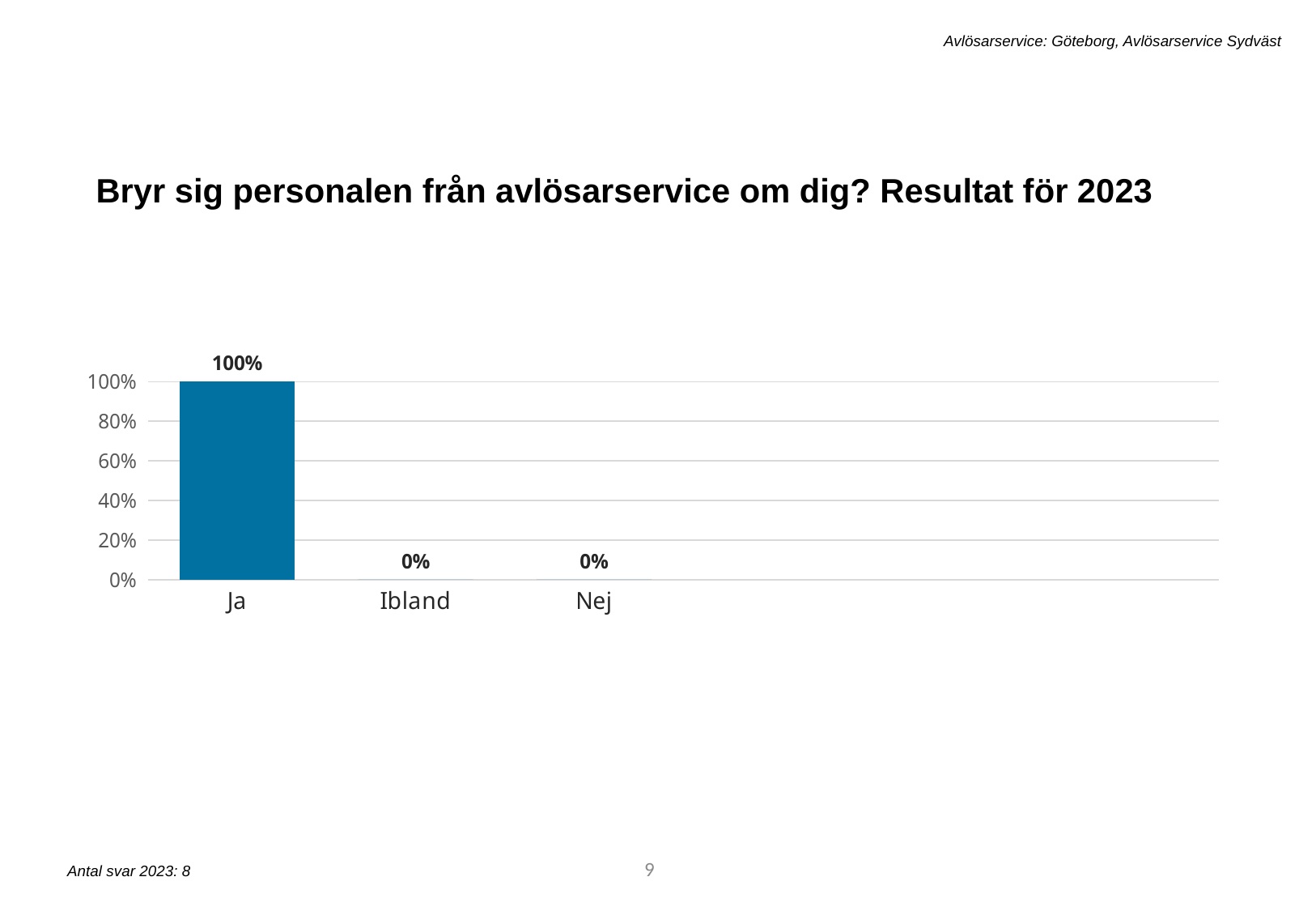
Do the values rise or fall from Ja to Nej along the x axis? fall Is the value for Ja greater or less than 80%? greater What is the title of the chart? Bryr sig personalen från avlösarservice om dig? Resultat för 2023 What is the value for Ja? 100% What kind of chart is shown on the slide? bar chart How many categories are shown on the x axis? 3 What is the difference between the values for Ja and Nej? 100% What is the value for Ibland? 0% What is the value for Nej? 0% Which is larger, the value for Ja or the value for Ibland? Ja What is the highest value shown on the y axis? 100% Which category has the highest value? Ja